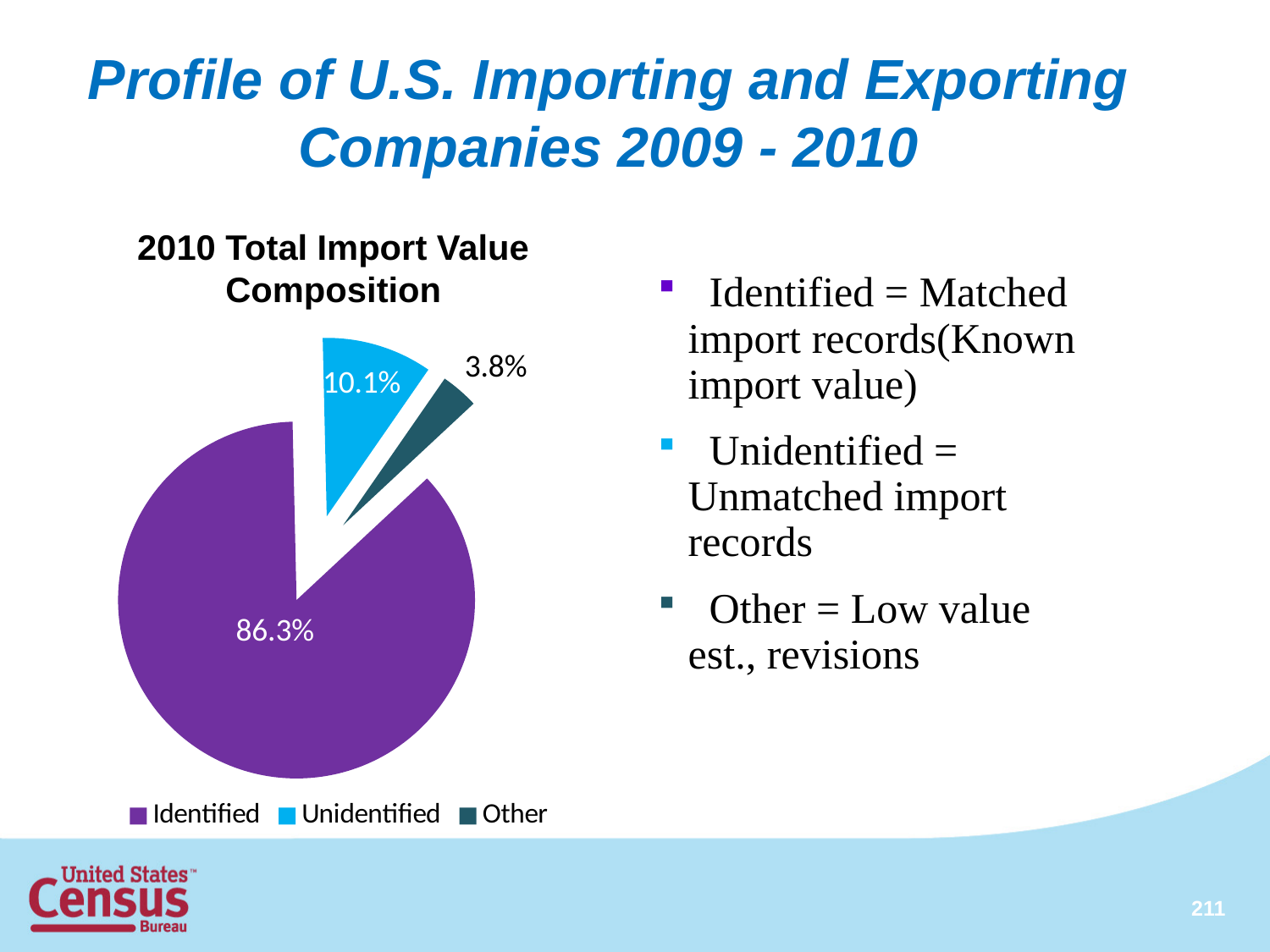
Which category has the largest slice of the pie? Identified What is the title of the chart? 2010 Total Import Value Composition How many categories does the pie chart show? 3 What is the difference in percentage points between the Unidentified and Other slices? 6.3 What is the difference in percentage points between the Identified and Unidentified slices? 76.2 What colour is the Identified slice in the pie chart? Purple What share of the pie does Other represent? 3.8% What share of the pie does Identified represent? 86.3% Which category has the smallest slice of the pie? Other Which slice is larger, Unidentified or Other? Unidentified What share of the pie does Unidentified represent? 10.1% What kind of chart is shown on the slide? Pie chart